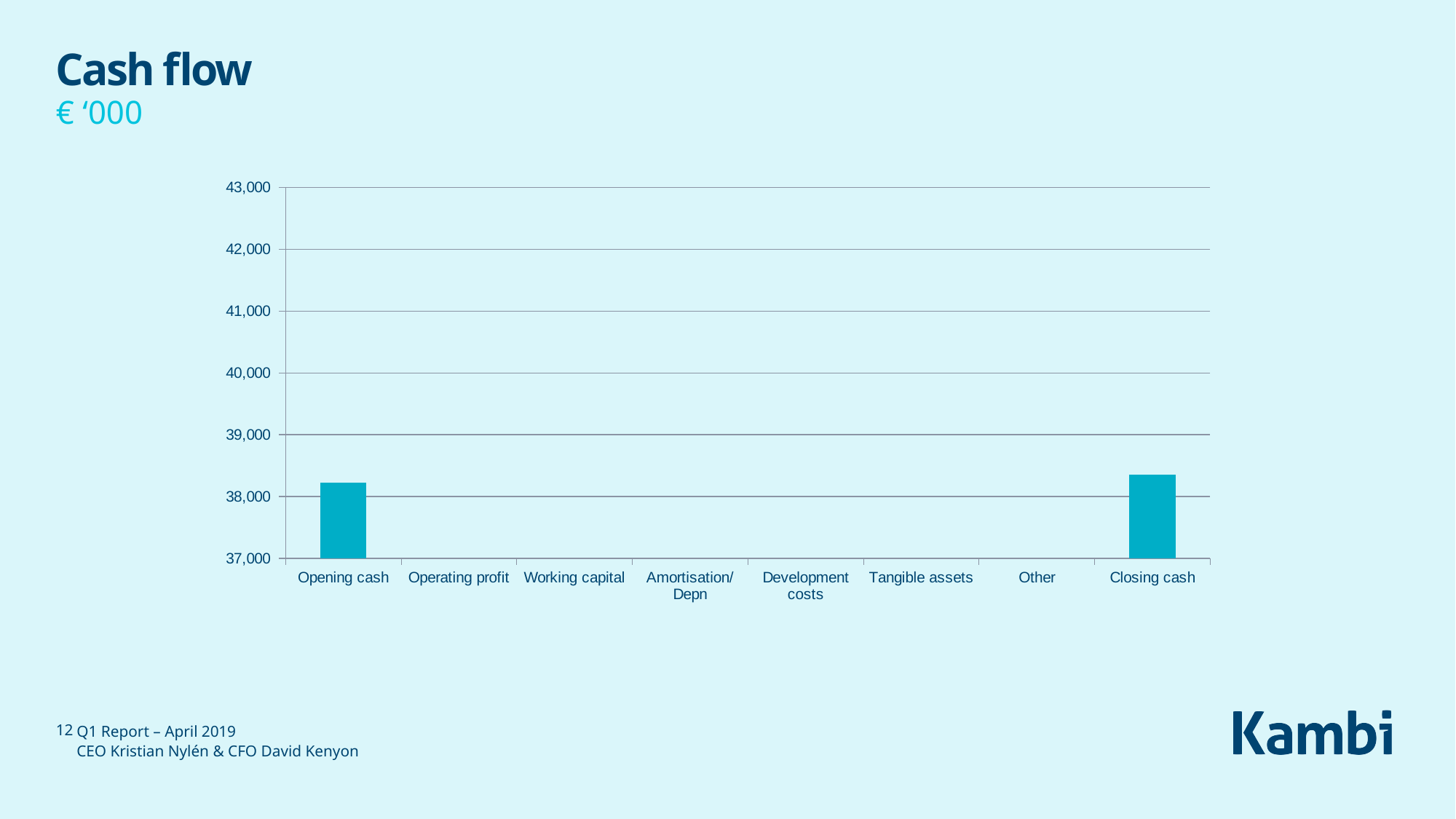
Is the value for Closing cash greater or less than 39,000? less Is the value for Closing cash greater or less than 38,000? greater Is the value for Opening cash greater or less than 38,000? greater What kind of chart is shown on the slide? bar chart What is the label of the first category on the x axis? Opening cash What is the title of the chart on the slide? Cash flow What is the lowest value shown on the y axis of the chart? 37,000 How many categories are listed along the x axis of the chart? 8